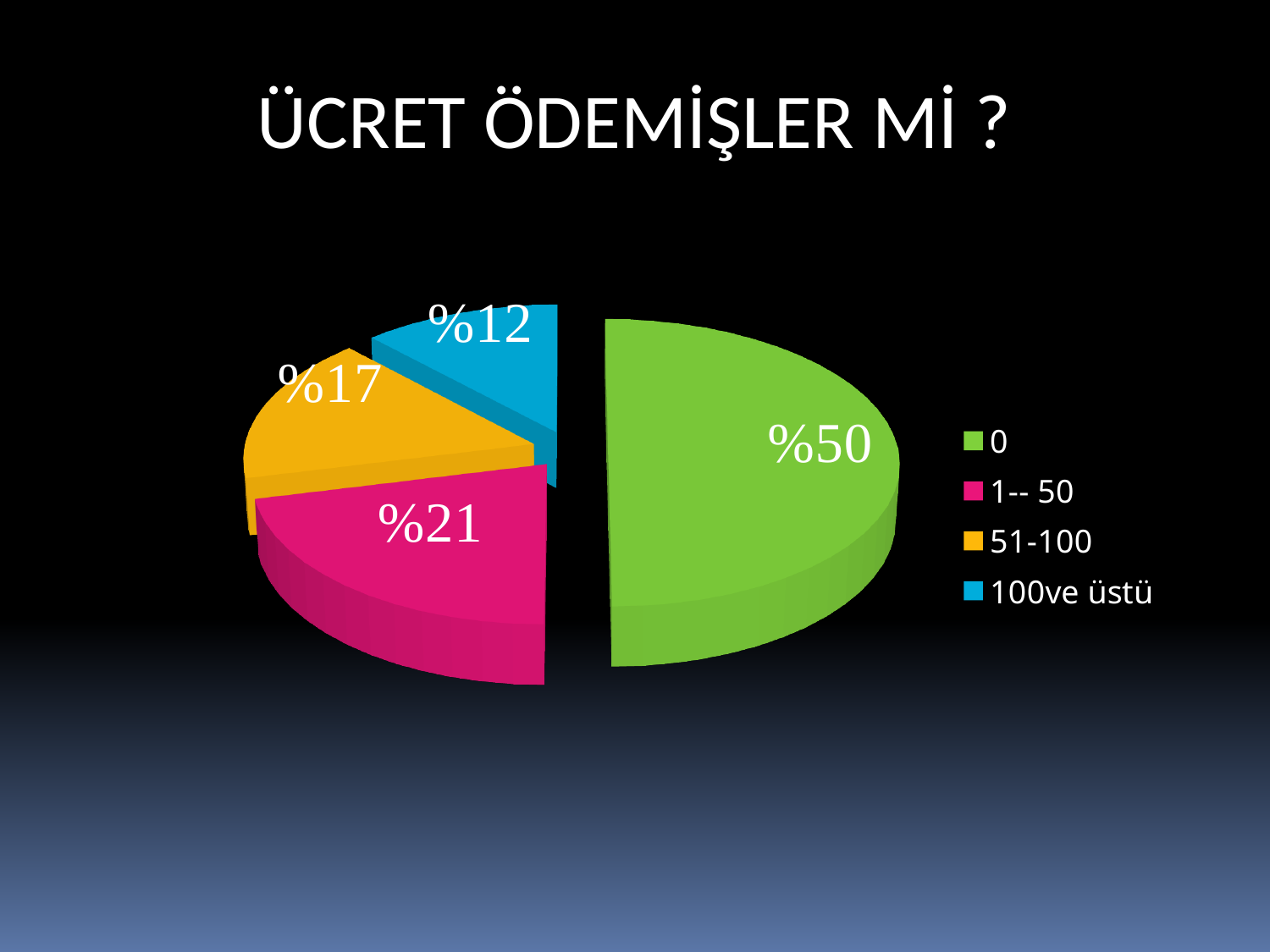
What is the value shown for the "0" slice? %50 What is the value shown for the "51-100" slice? %17 How many entries does the legend list? 4 How many slices does the pie chart have? 4 What is the value shown for the "1-- 50" slice? %21 What kind of chart is shown on the slide? Pie chart What is the difference between the "0" slice and the "1-- 50" slice? %29 Which category has the smallest slice of the pie? 100ve üstü What is the title of the slide? ÜCRET ÖDEMİŞLER Mİ ? What is the value shown for the "100ve üstü" slice? %12 Which category has the largest slice of the pie? 0 Which is larger, the "51-100" slice or the "100ve üstü" slice? 51-100